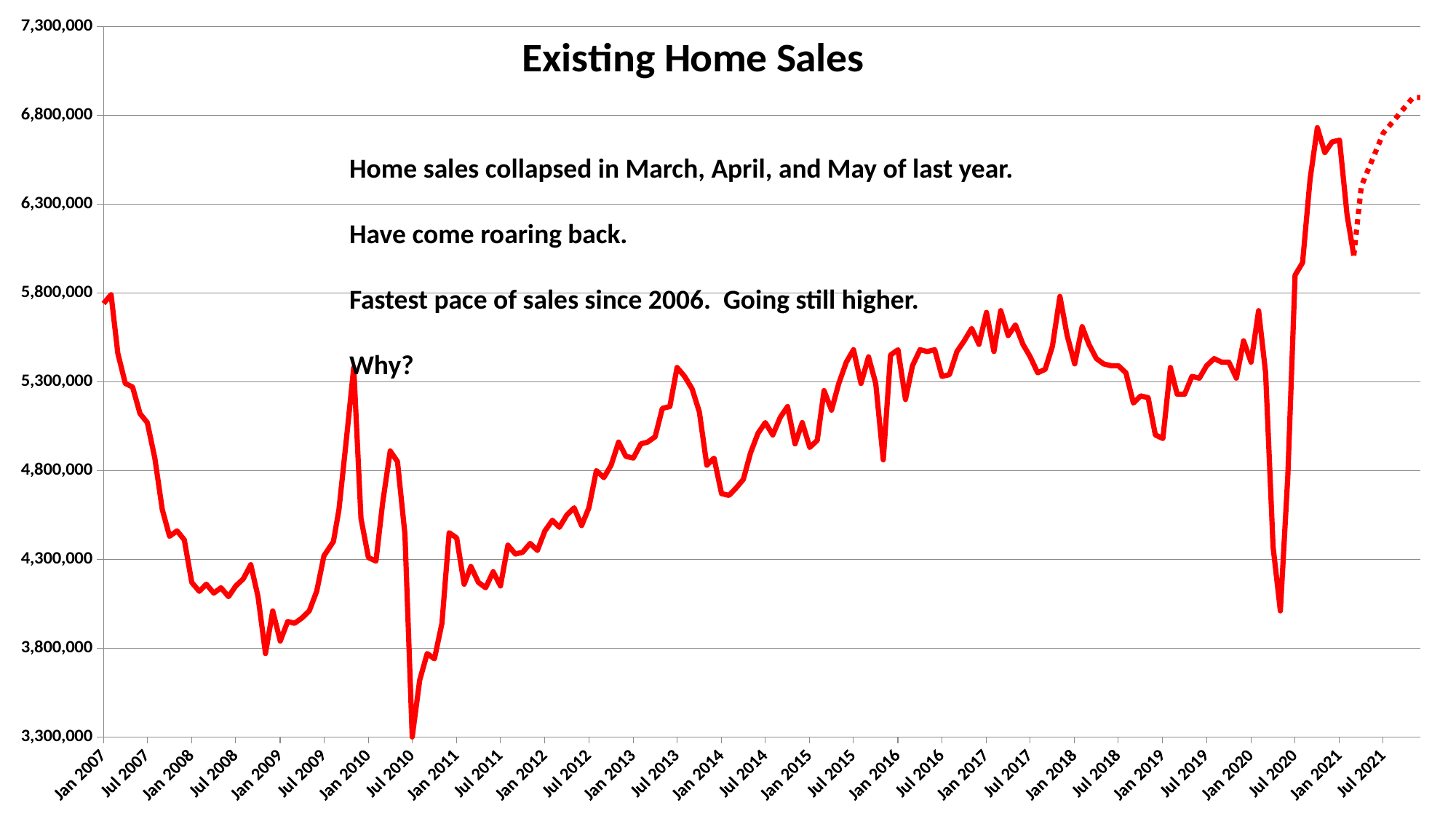
Do existing home sales rise or fall between Jul 2010 and Jan 2013? rise What kind of chart is shown on the slide? line chart Is the value for Jul 2008 greater or less than 4,300,000? less Is the value for Jan 2021 greater or less than 6,300,000? greater How many data series are plotted on the chart? 2 What colour is the line plotted on the chart? red In which year does the line reach its lowest point? 2010 Is the value for Jul 2010 greater or less than 3,800,000? less Do existing home sales rise or fall between Jan 2007 and Jan 2009? fall What is the title of the chart? Existing Home Sales